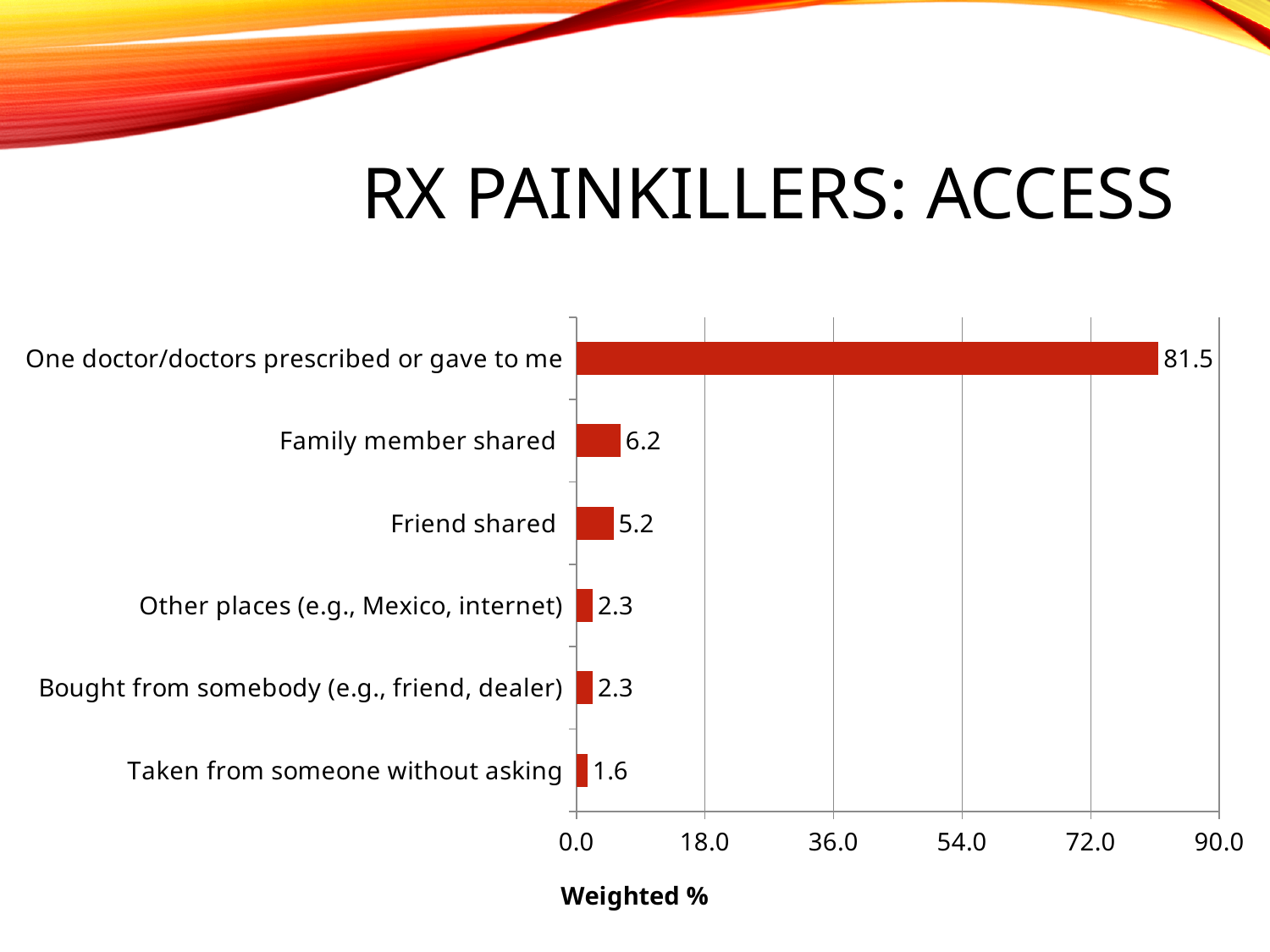
Is the value for "One doctor/doctors prescribed or gave to me" greater or less than 72.0? greater Which category has the lowest weighted %? Taken from someone without asking What is the weighted % for "Taken from someone without asking"? 1.6 Which is larger: the weighted % for "Friend shared" or for "Other places (e.g., Mexico, internet)"? Friend shared What is the label of the horizontal axis? Weighted % What is the weighted % for "One doctor/doctors prescribed or gave to me"? 81.5 How many categories are shown in the chart? 6 What is the weighted % for "Friend shared"? 5.2 What is the weighted % for "Family member shared"? 6.2 What is the difference in weighted % between "Family member shared" and "Friend shared"? 1.0 Which category has the highest weighted %? One doctor/doctors prescribed or gave to me What kind of chart is shown on the slide? Bar chart